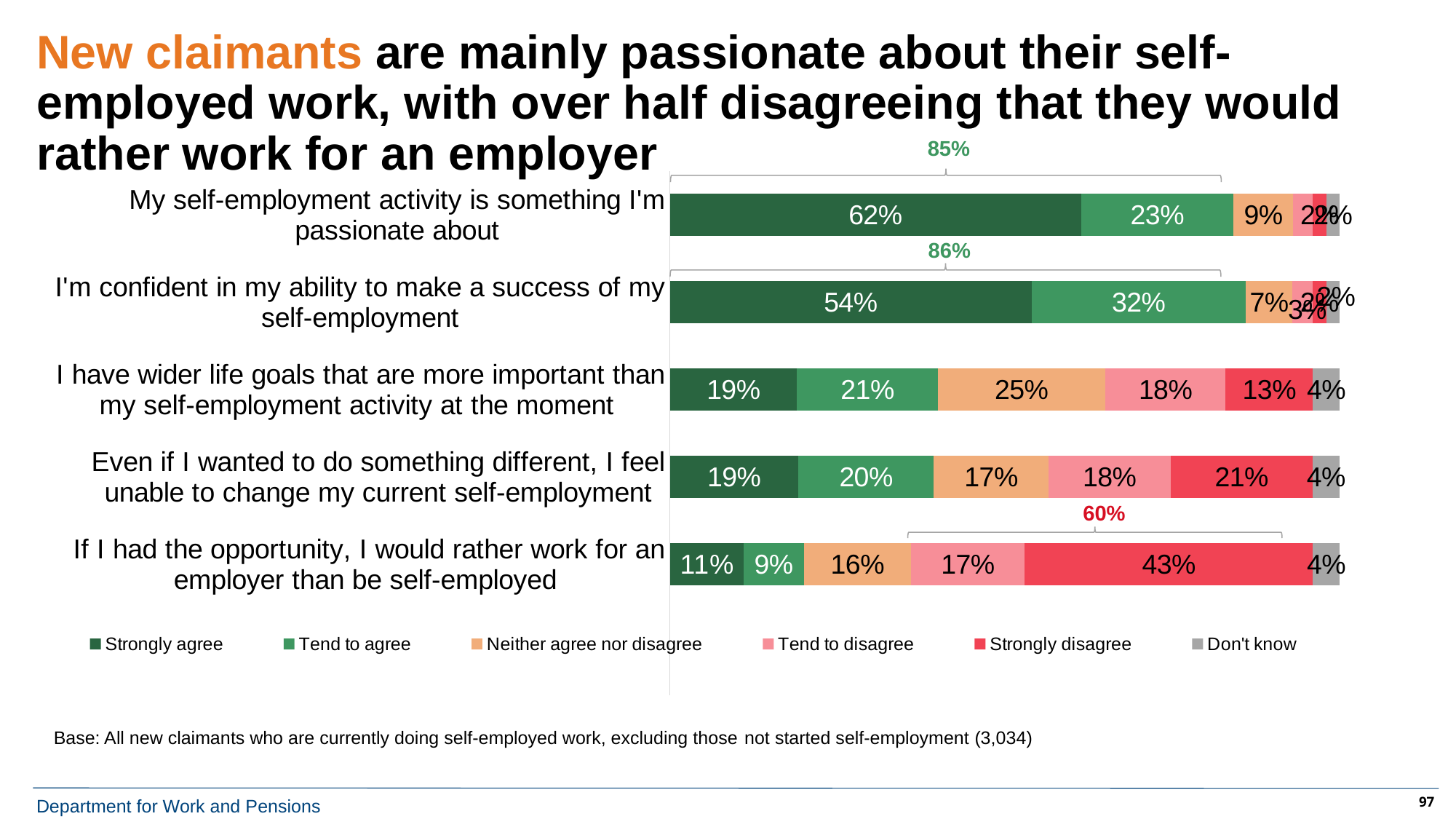
What percentage of new claimants strongly agree that their self-employment activity is something they are passionate about? 62% Which is larger: the 'Tend to disagree' share for 'I have wider life goals...' or the 'Strongly disagree' share for the same statement? Tend to disagree (18%) How many response categories does the legend list? 6 Which statement has the highest 'Strongly agree' percentage? My self-employment activity is something I'm passionate about What combined percentage agree (strongly or tend to) that they are confident in their ability to make a success of their self-employment, as shown by the bracket label? 86% What combined percentage disagree that they would rather work for an employer than be self-employed, as shown by the bracket label? 60% What is the difference between the 'Strongly disagree' percentage for 'If I had the opportunity, I would rather work for an employer' and for 'Even if I wanted to do something different, I feel unable to change my current self-employment'? 22 percentage points What percentage strongly disagree that, if they had the opportunity, they would rather work for an employer than be self-employed? 43% Which statement has the lowest 'Strongly agree' percentage? If I had the opportunity, I would rather work for an employer than be self-employed What type of chart is shown on the slide? Stacked bar chart What percentage tend to agree that they are confident in their ability to make a success of their self-employment? 32% What percentage neither agree nor disagree that they have wider life goals that are more important than their self-employment activity at the moment? 25%